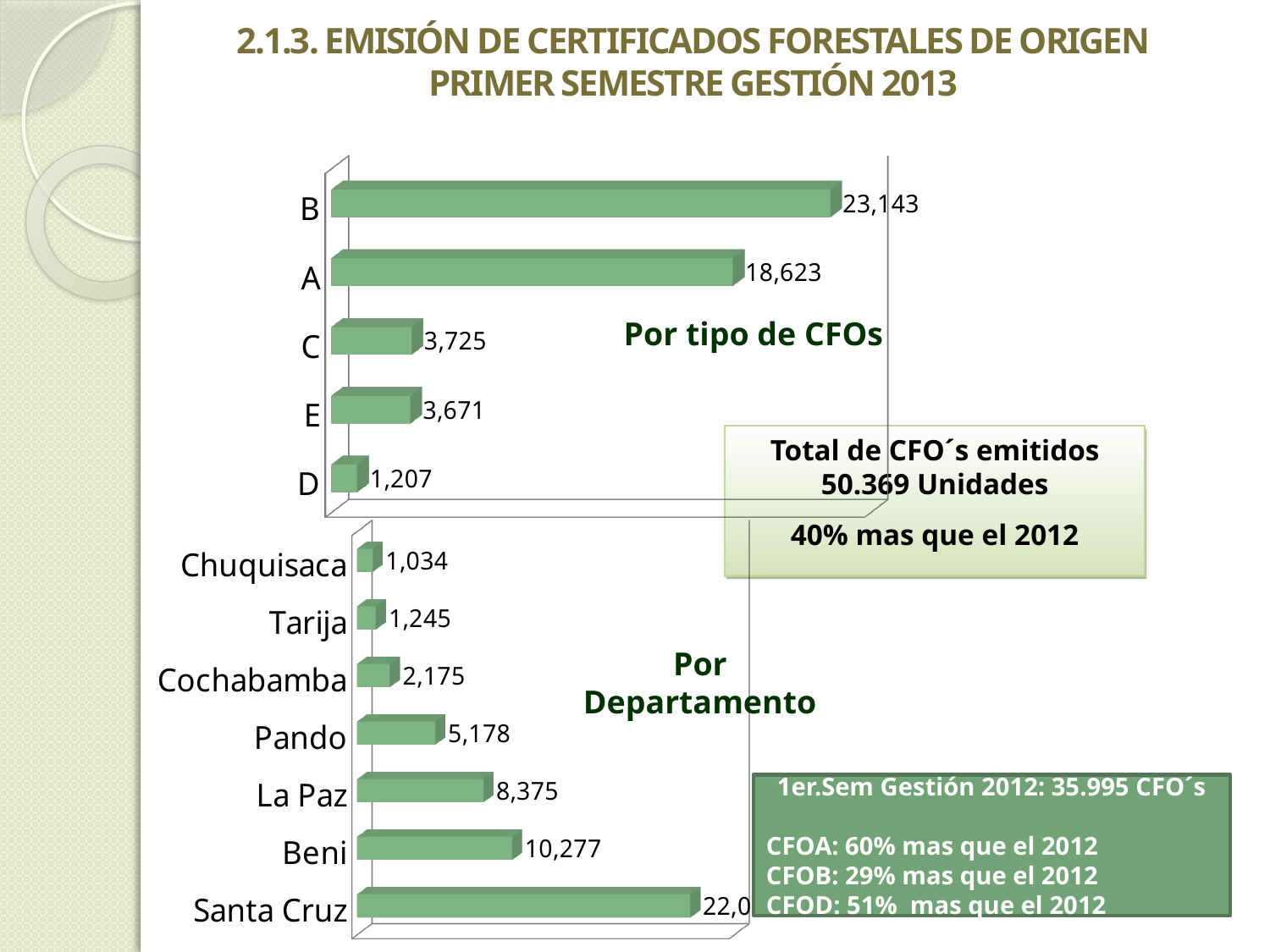
In the 'Por Departamento' chart, what is the value for Pando? 5,178 In the 'Por Departamento' chart, which department has the highest value? Santa Cruz In the 'Por tipo de CFOs' chart, what is the value for type B? 23,143 In the 'Por Departamento' chart, which is larger, the value for La Paz or the value for Cochabamba? La Paz In the 'Por tipo de CFOs' chart, what is the difference between the values for B and A? 4,520 In the 'Por Departamento' chart, which department has the lowest value? Chuquisaca In the 'Por tipo de CFOs' chart, what is the value for type D? 1,207 In the 'Por tipo de CFOs' chart, what is the value for type A? 18,623 In the 'Por tipo de CFOs' chart, which type has the lowest value? D In the 'Por tipo de CFOs' chart, how many types of CFOs are shown? 5 In the 'Por Departamento' chart, what is the value for Beni? 10,277 In the 'Por tipo de CFOs' chart, which type has the highest value? B